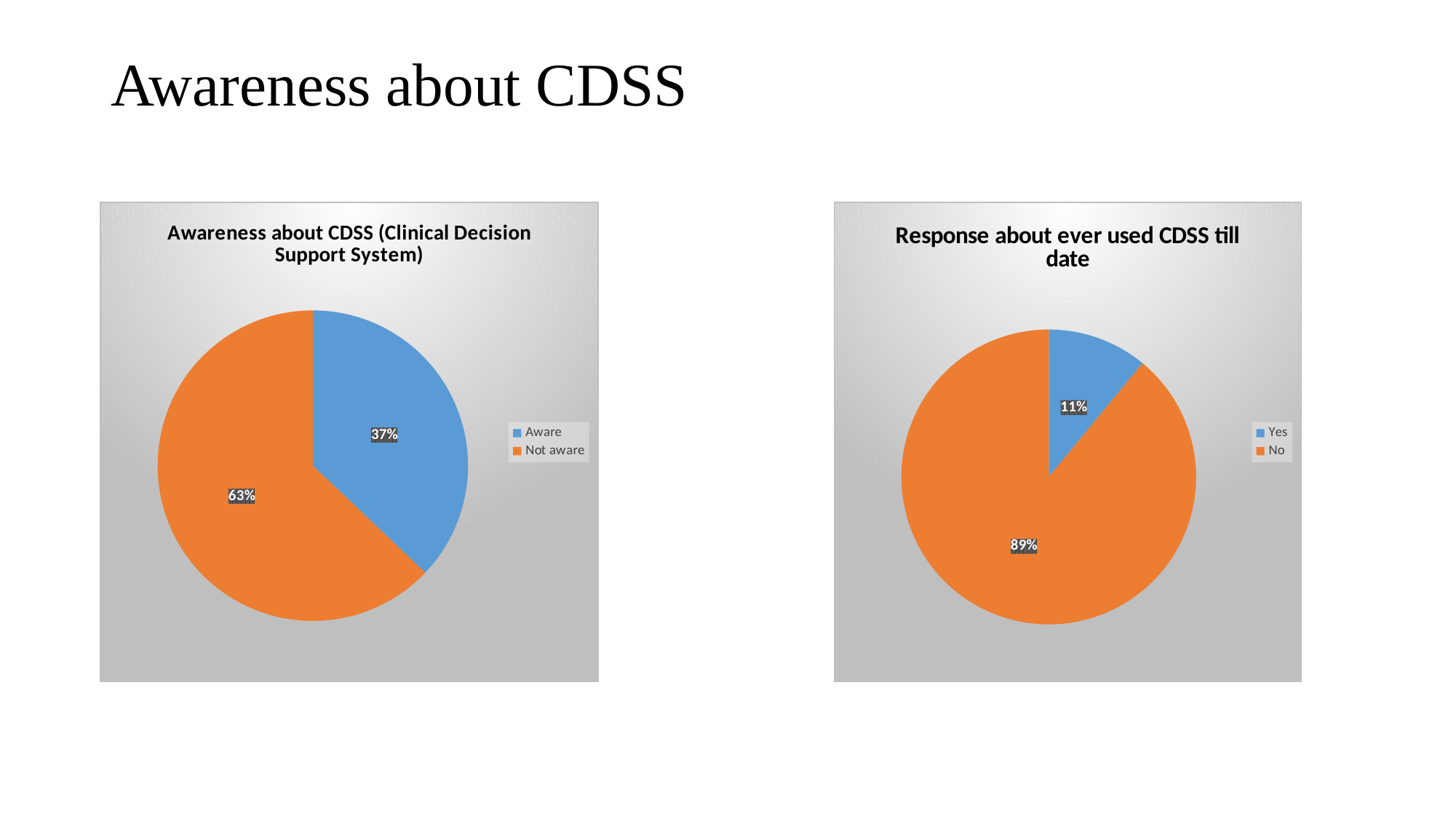
In the 'Awareness about CDSS (Clinical Decision Support System)' chart, how many categories does the legend list? 2 In the 'Response about ever used CDSS till date' chart, what share of respondents answered Yes? 11% In the 'Awareness about CDSS (Clinical Decision Support System)' chart, what share of respondents are Aware? 37% In the 'Response about ever used CDSS till date' chart, what share of respondents answered No? 89% In the 'Awareness about CDSS (Clinical Decision Support System)' chart, what is the difference in percentage points between Not aware and Aware? 26 How many pie charts are shown on the slide? 2 In the 'Response about ever used CDSS till date' chart, which colour represents the No category? Orange In the 'Response about ever used CDSS till date' chart, which category has the smallest slice? Yes In the 'Awareness about CDSS (Clinical Decision Support System)' chart, which category has the largest slice? Not aware In the 'Response about ever used CDSS till date' chart, what is the difference in percentage points between No and Yes? 78 What type of chart is the 'Awareness about CDSS (Clinical Decision Support System)' chart? Pie chart